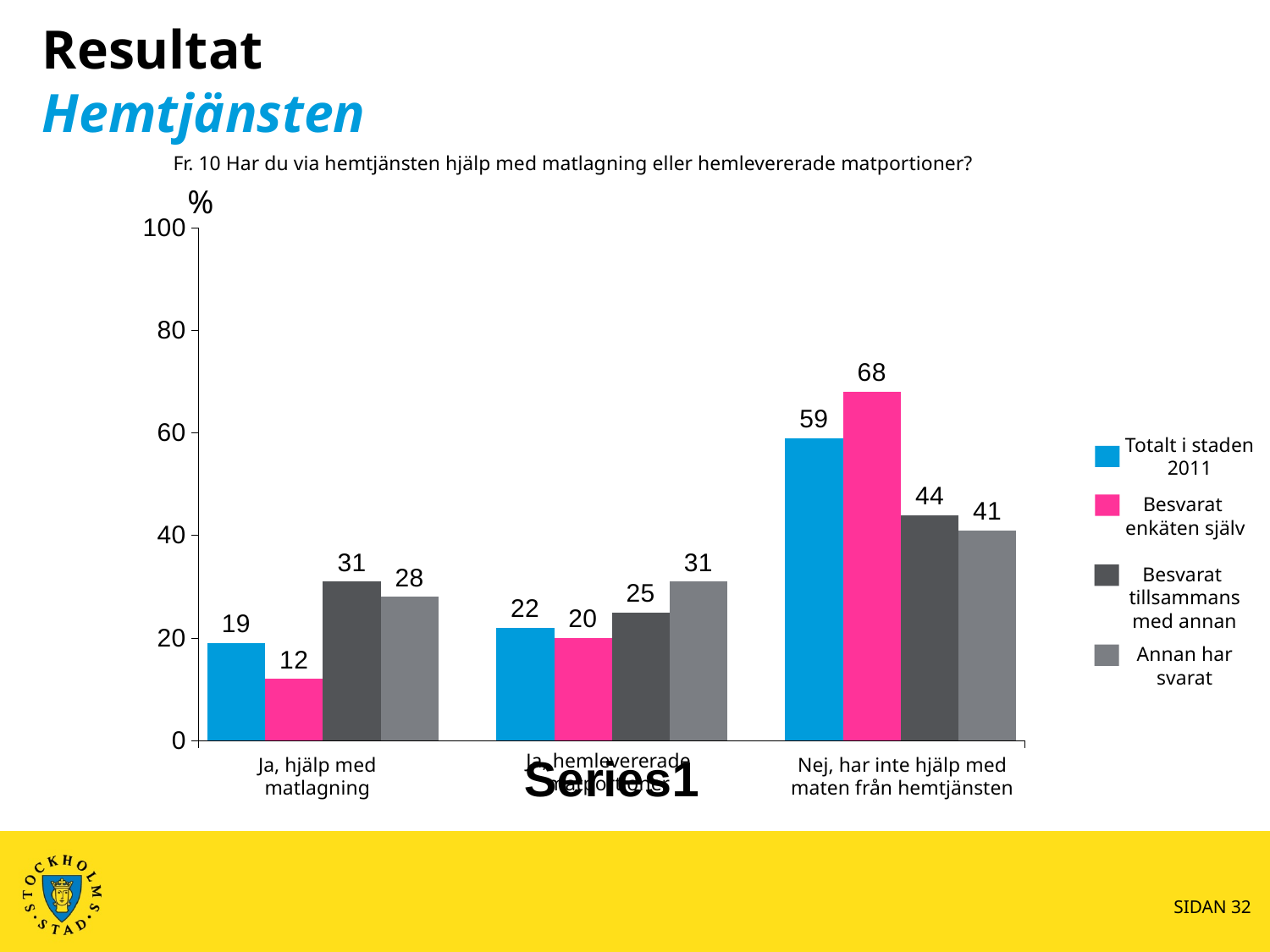
Is the value for 'Totalt i staden 2011' in the category 'Nej, har inte hjälp med maten från hemtjänsten' greater or less than 40? greater How many categories are shown on the x axis? 3 Which series has the highest value in the category 'Nej, har inte hjälp med maten från hemtjänsten'? Besvarat enkäten själv What is the value for 'Besvarat tillsammans med annan' in the category 'Ja, hjälp med matlagning'? 31 What is the difference between 'Besvarat enkäten själv' and 'Totalt i staden 2011' in the category 'Nej, har inte hjälp med maten från hemtjänsten'? 9 In the category 'Ja, hjälp med matlagning', which is larger: 'Besvarat tillsammans med annan' or 'Annan har svarat'? Besvarat tillsammans med annan Which series has the lowest value in the category 'Ja, hjälp med matlagning'? Besvarat enkäten själv What is the value for 'Besvarat enkäten själv' in the category 'Nej, har inte hjälp med maten från hemtjänsten'? 68 What kind of chart is shown on the slide? Bar chart What is the value for 'Annan har svarat' in the middle category ('Ja, hemlevererade matportioner')? 31 What is the value for 'Totalt i staden 2011' in the category 'Ja, hjälp med matlagning'? 19 How many series does the legend list? 4